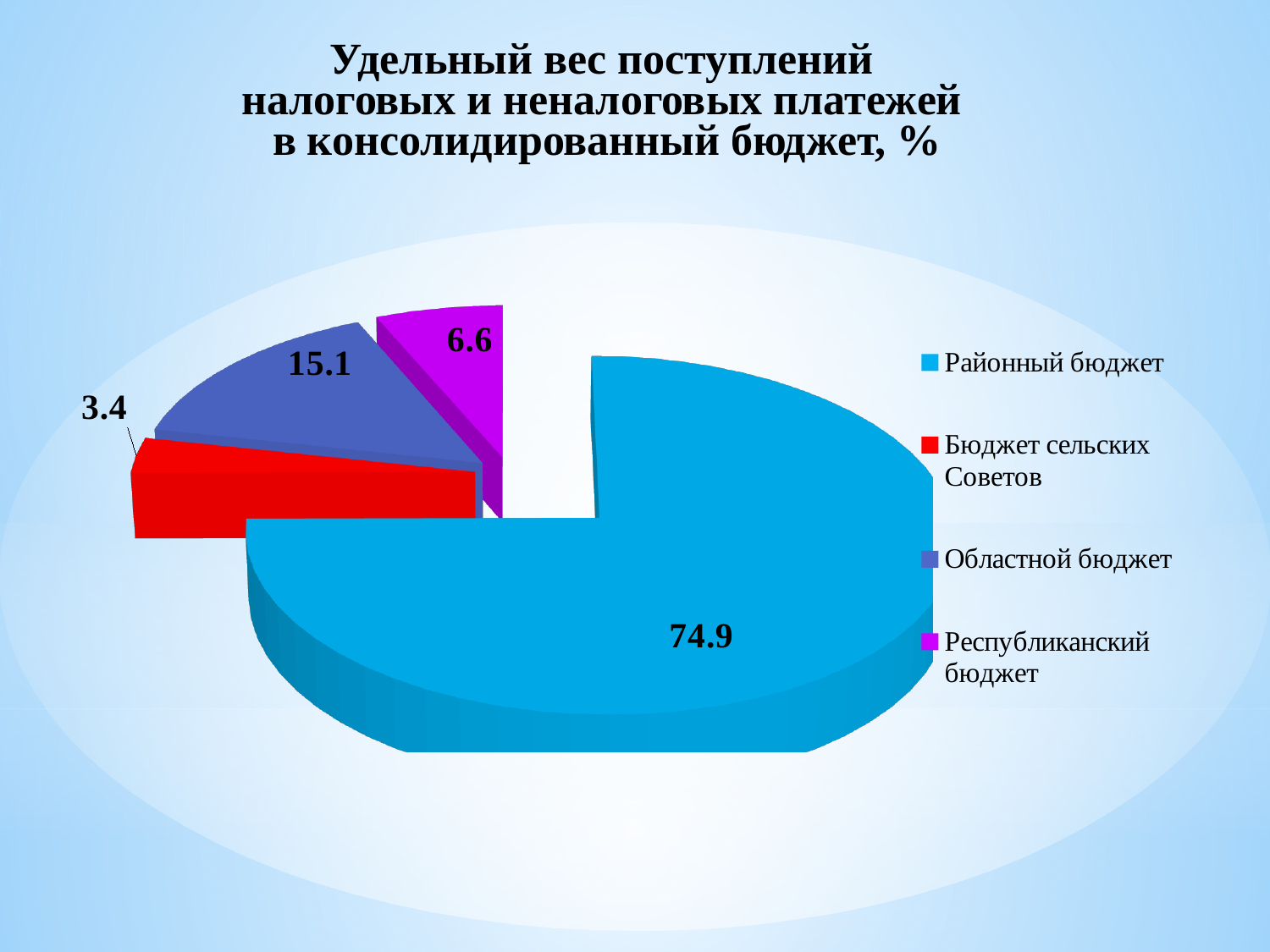
What is the value for Республиканский бюджет? 6.6 What is the difference between the values for Районный бюджет and Областной бюджет? 59.8 Which category has the smallest slice of the pie? Бюджет сельских Советов How many slices does the pie chart have? 4 Which is larger, the value for Республиканский бюджет or the value for Бюджет сельских Советов? Республиканский бюджет What is the value for Областной бюджет? 15.1 What kind of chart is shown on the slide? Pie chart What colour is the slice for Бюджет сельских Советов? Red What is the value for Бюджет сельских Советов? 3.4 Which category has the largest slice of the pie? Районный бюджет What is the value for Районный бюджет? 74.9 What is the difference between the values for Областной бюджет and Республиканский бюджет? 8.5